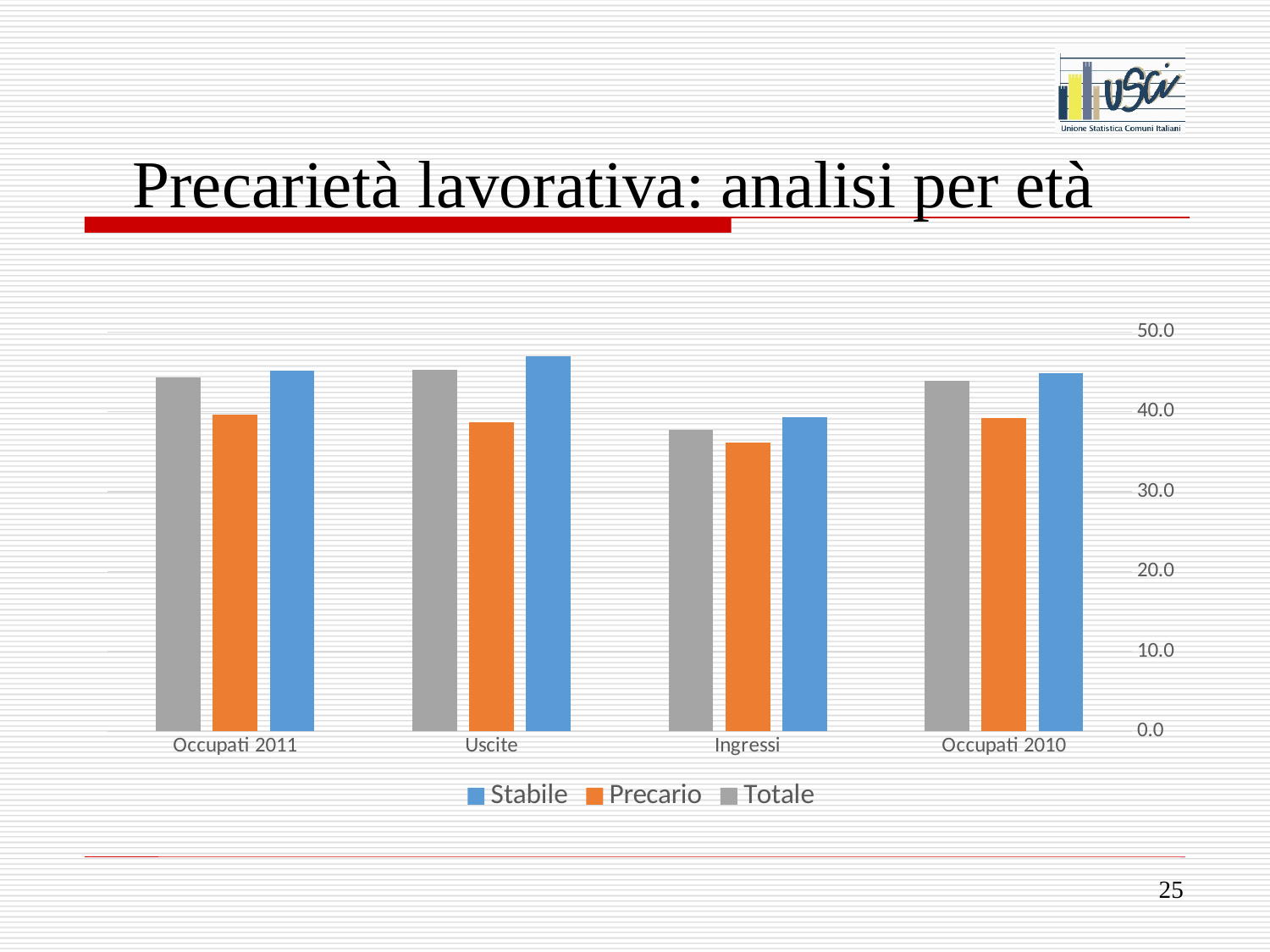
What kind of chart is shown on the slide? bar chart How many series does the chart legend list? 3 Is the Stabile value for Uscite greater or less than 40? greater How many categories are shown on the x axis of the chart? 4 Within the Uscite category, which series has the highest bar? Stabile Which series is shown in orange in the chart? Precario Is the Precario value for Uscite greater or less than 40? less Within the Ingressi category, which series has the lowest bar? Precario What is the title of the slide containing the chart? Precarietà lavorativa: analisi per età Is the Totale value for Occupati 2011 greater or less than 40? greater For Occupati 2011, which is larger: the Stabile value or the Precario value? Stabile